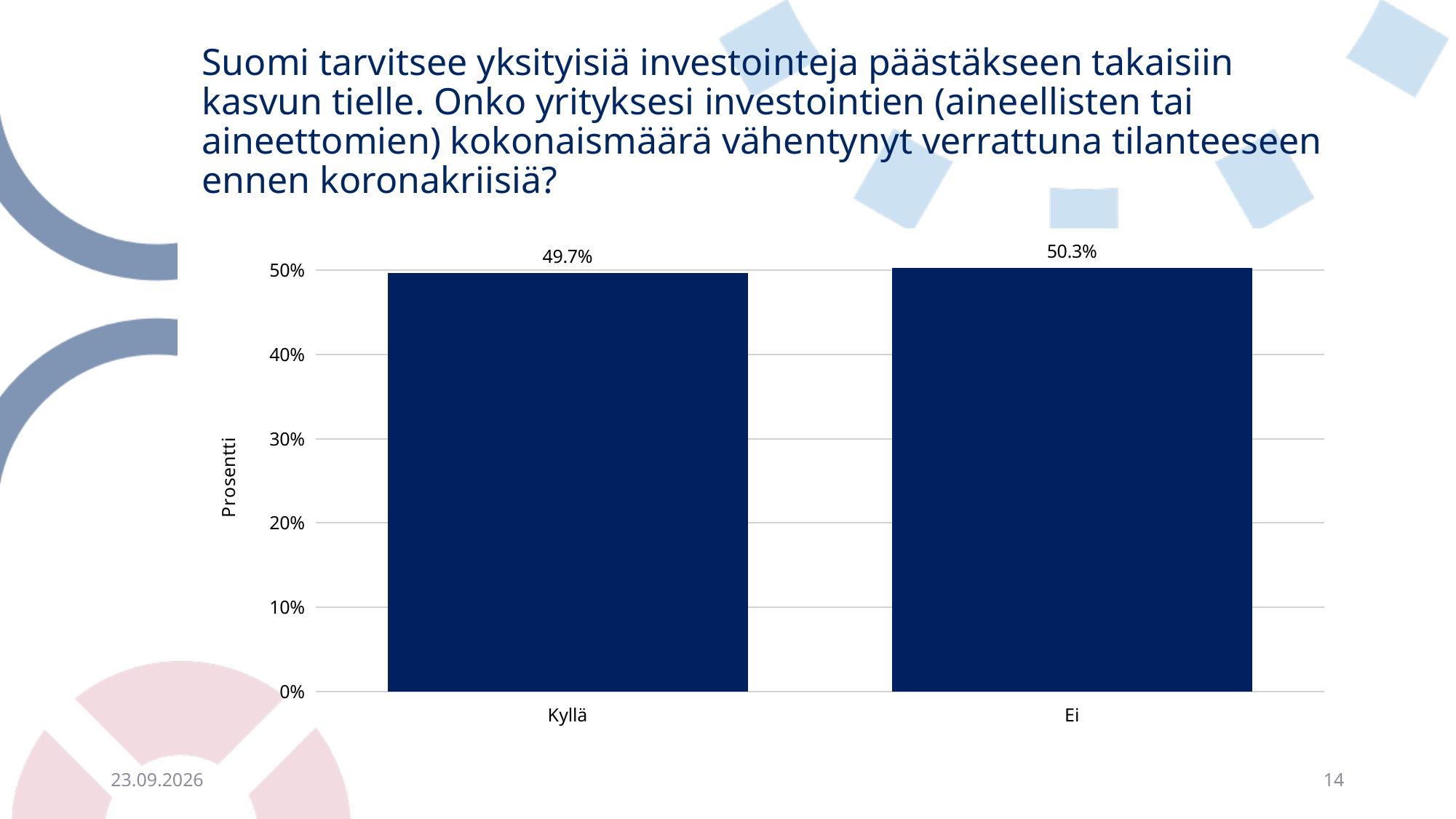
Which category has the lowest value? Kyllä What is the value for Kyllä? 49.7% What is the label of the vertical axis? Prosentti Is the value for Ei greater or less than 30%? greater What is the highest tick value shown on the vertical axis? 50% What kind of chart is shown on the slide? bar chart How many categories are shown on the x axis? 2 Which is larger, the value for Kyllä or the value for Ei? Ei What is the value for Ei? 50.3% What is the difference between the values for Ei and Kyllä? 0.6% Which category has the highest value? Ei Is the value for Kyllä greater or less than 40%? greater